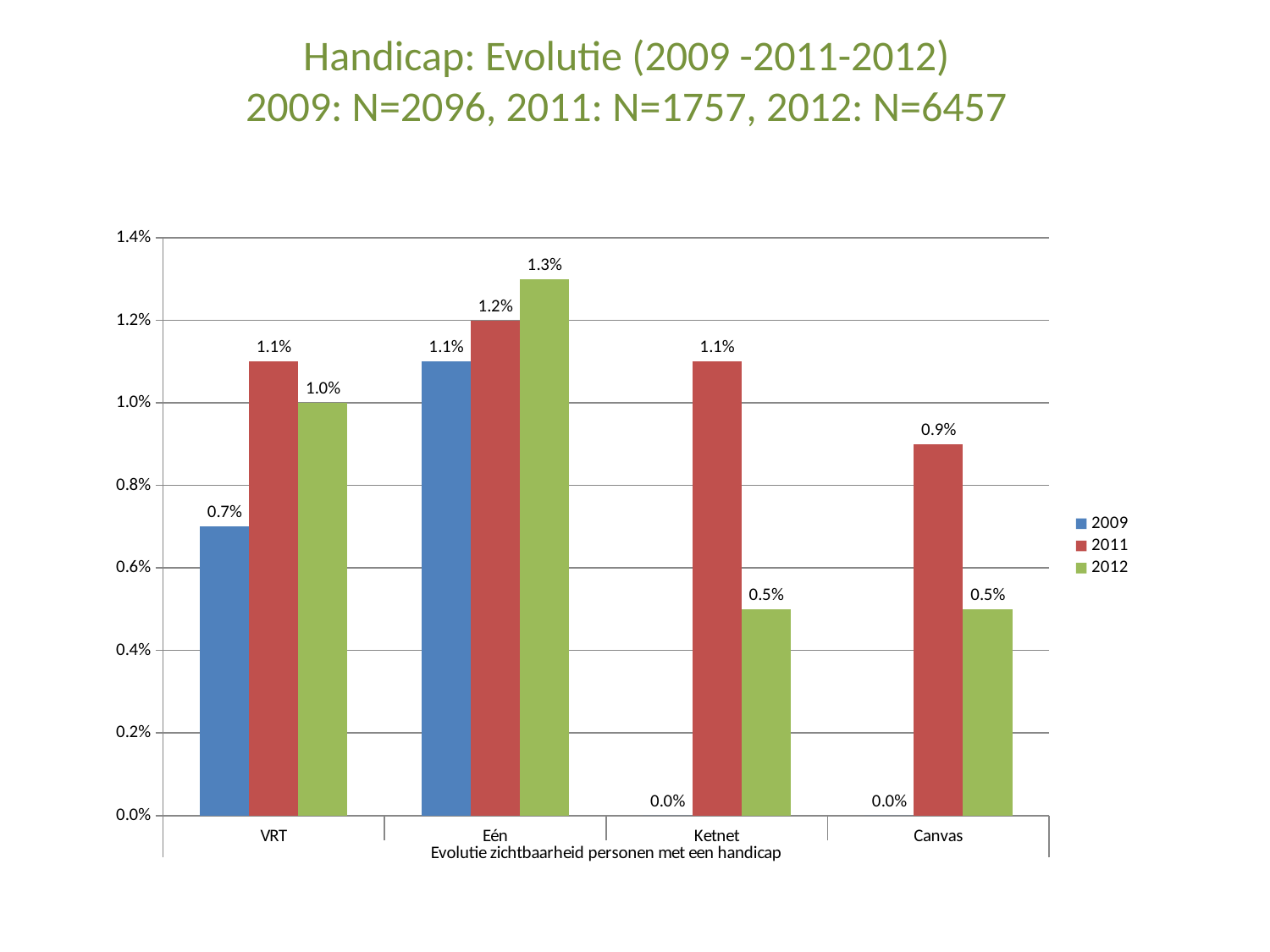
What is the value for Eén in 2012? 1.3% What is the label shown below the x axis categories? Evolutie zichtbaarheid personen met een handicap How many series does the legend list? 3 Which category has the lowest value for the 2011 series? Canvas What is the value for Canvas in 2011? 0.9% What is the value for Ketnet in 2012? 0.5% What is the difference between the 2012 and 2009 values for Eén? 0.2% What kind of chart is shown on the slide? Bar chart Which category has the highest value for the 2012 series? Eén Which is larger for Ketnet: the 2011 value or the 2012 value? 2011 What is the value for VRT in 2009? 0.7% How many categories are shown on the x axis? 4